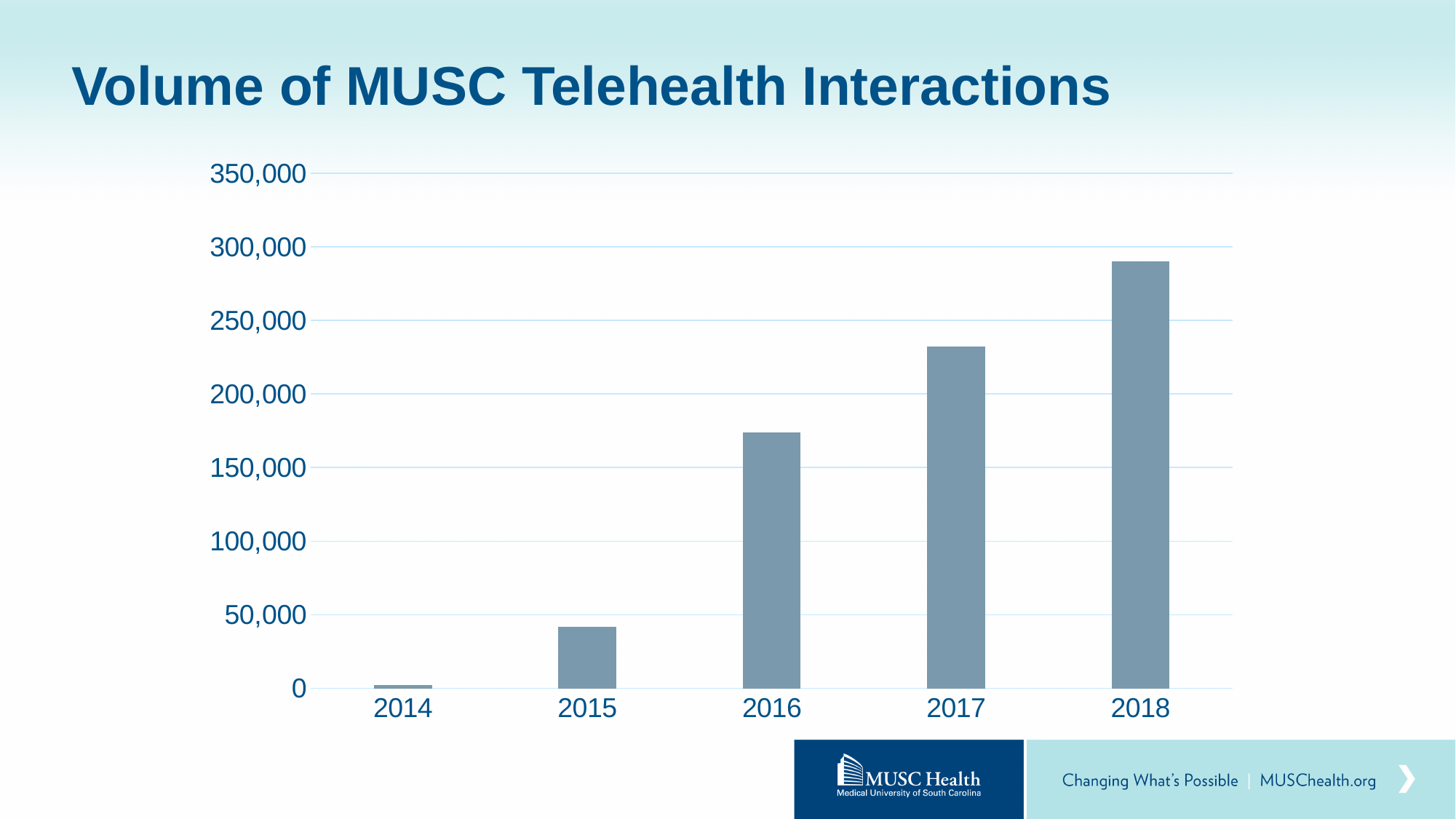
Is the value for 2018 greater or less than 250,000? greater What type of chart is shown on the slide? bar chart Is the value for 2016 greater or less than 150,000? greater Is the value for 2017 greater or less than 250,000? less How many years are shown on the x axis? 5 Do the values rise or fall from 2014 to 2018? rise What is the title of the chart? Volume of MUSC Telehealth Interactions Which year has a larger value, 2016 or 2017? 2017 Which year has the highest volume of telehealth interactions? 2018 Which year has the lowest volume of telehealth interactions? 2014